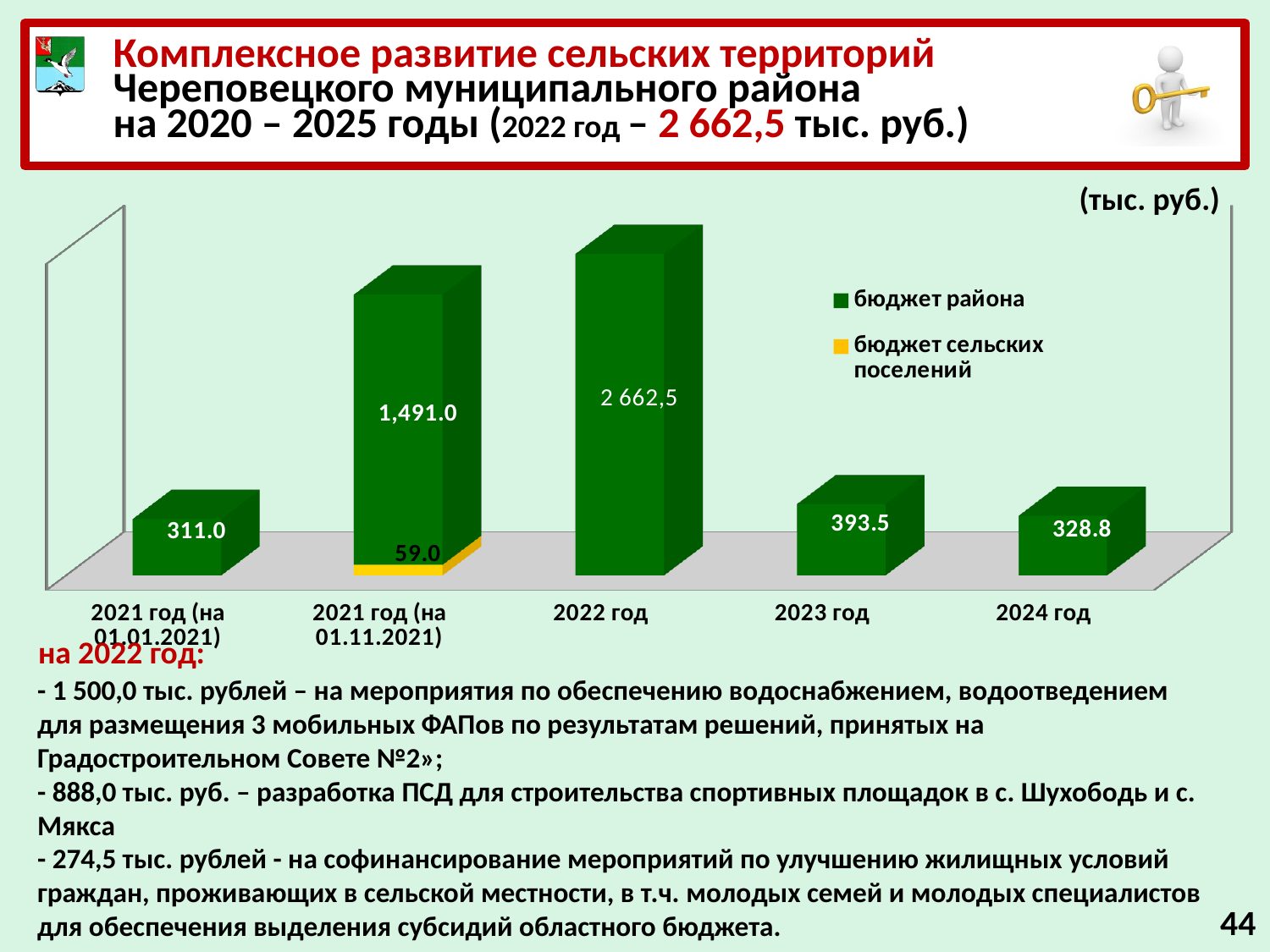
How many series does the legend list? 2 Which is larger, the бюджет района value for 2023 год or for 2021 год (на 01.01.2021)? 2023 год Which category has the highest value for бюджет района? 2022 год What is the value of бюджет района for 2024 год? 328.8 Which category has the lowest value for бюджет района? 2021 год (на 01.01.2021) What is the difference between the бюджет района values for 2023 год and 2024 год? 64.7 What type of chart is shown on the slide? bar chart What is the value of бюджет района for 2021 год (на 01.11.2021)? 1,491.0 What is the value of бюджет района for 2022 год? 2 662,5 How many categories are shown on the x axis? 5 What is the value of бюджет сельских поселений for 2021 год (на 01.11.2021)? 59.0 What is the total of the stacked bar for 2021 год (на 01.11.2021)? 1,550.0